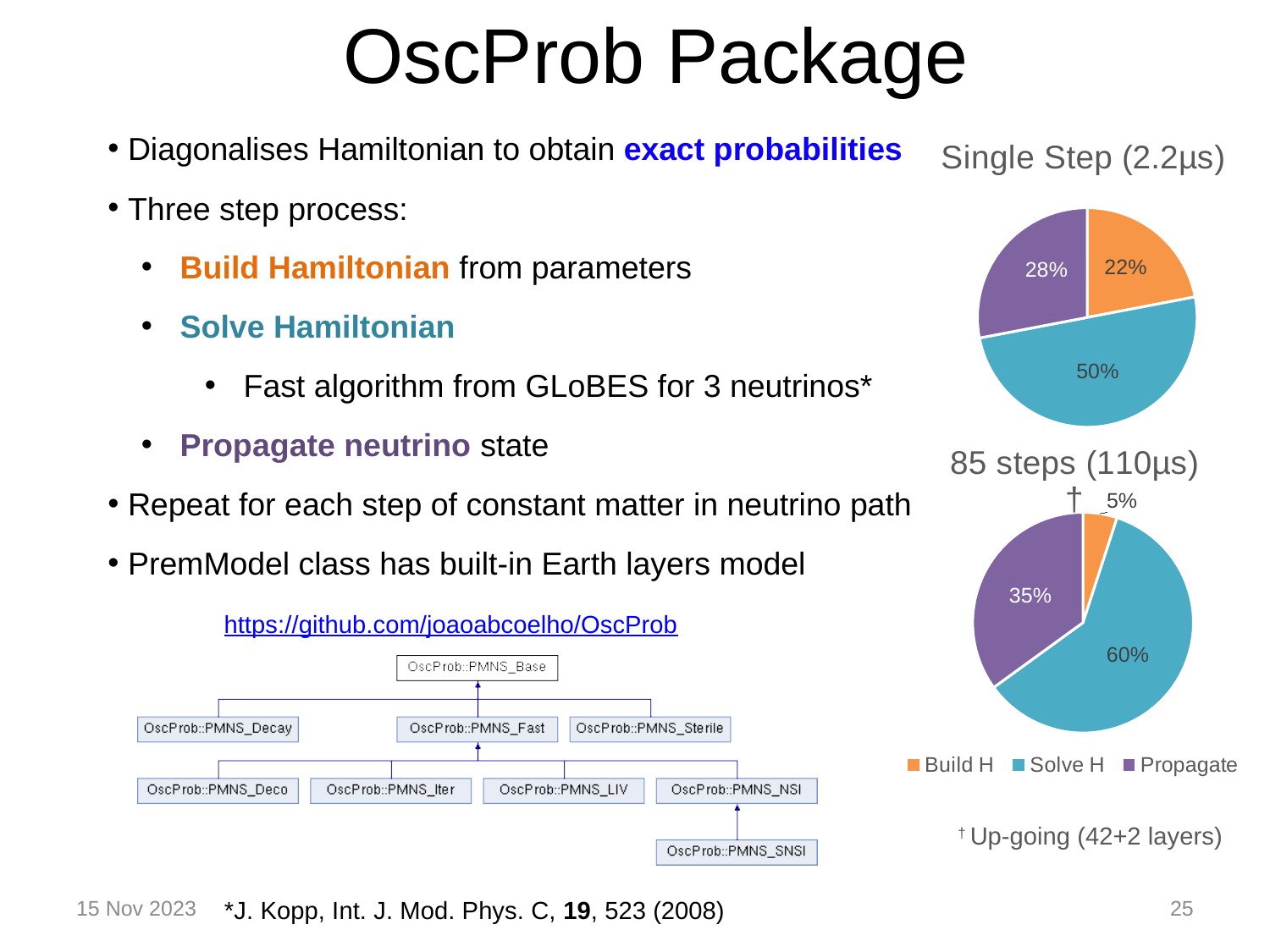
In the '85 steps (110μs)' pie chart, what share does Build H have? 5% In the 'Single Step (2.2μs)' pie chart, what is the difference between the Solve H share and the Propagate share? 22% In the '85 steps (110μs)' pie chart, which category has the largest share? Solve H What kind of chart is used for 'Single Step (2.2μs)'? pie chart In the 'Single Step (2.2μs)' pie chart, what share does Solve H have? 50% In the '85 steps (110μs)' pie chart, what share does Propagate have? 35% In the '85 steps (110μs)' pie chart, which category has the smallest share? Build H In the 'Single Step (2.2μs)' pie chart, what share does Propagate have? 28% In the 'Single Step (2.2μs)' pie chart, which category has the smallest share? Build H How many categories does the legend below the pie charts list? 3 In the 'Single Step (2.2μs)' pie chart, what share does Build H have? 22% In the '85 steps (110μs)' pie chart, is the share for Propagate larger or smaller than the share for Solve H? smaller